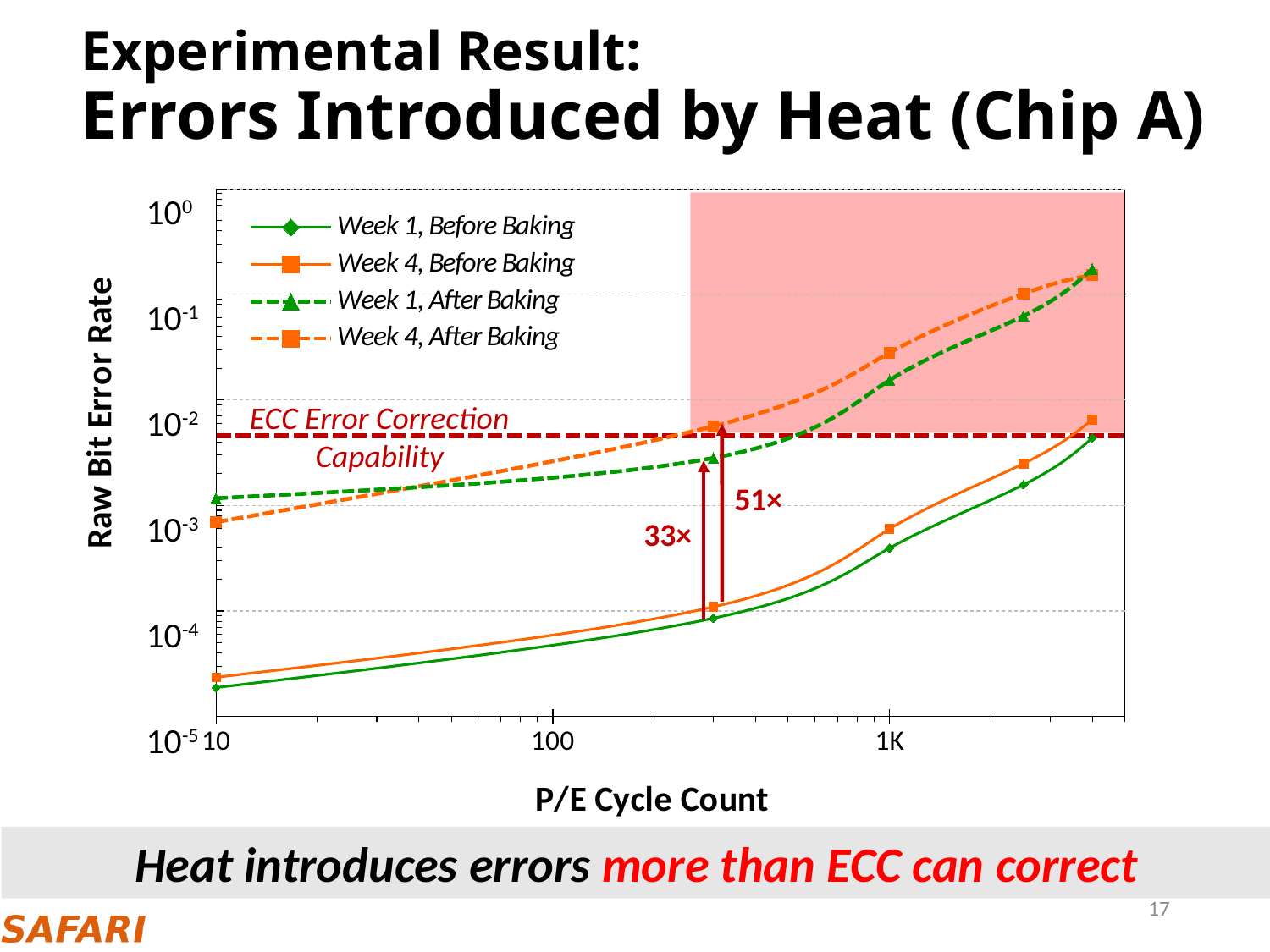
At 1K P/E cycles, which has the higher raw bit error rate: Week 4, After Baking or Week 1, Before Baking? Week 4, After Baking Is the raw bit error rate for Week 1, Before Baking at 10 P/E cycles greater or less than 10^-4? less Is the raw bit error rate for Week 1, After Baking at 10 P/E cycles greater or less than 10^-3? greater Does the raw bit error rate rise or fall as the P/E cycle count increases? rise What is the label of the x axis? P/E Cycle Count Is the raw bit error rate for Week 1, Before Baking at 1K P/E cycles greater or less than 10^-3? less How many series does the legend list? 4 What factor of increase is annotated for the Week 4 curves at around 300 P/E cycles? 51× What factor of increase is annotated for the Week 1 curves at around 300 P/E cycles? 33× What kind of chart is shown on the slide? line chart What is the label of the y axis? Raw Bit Error Rate